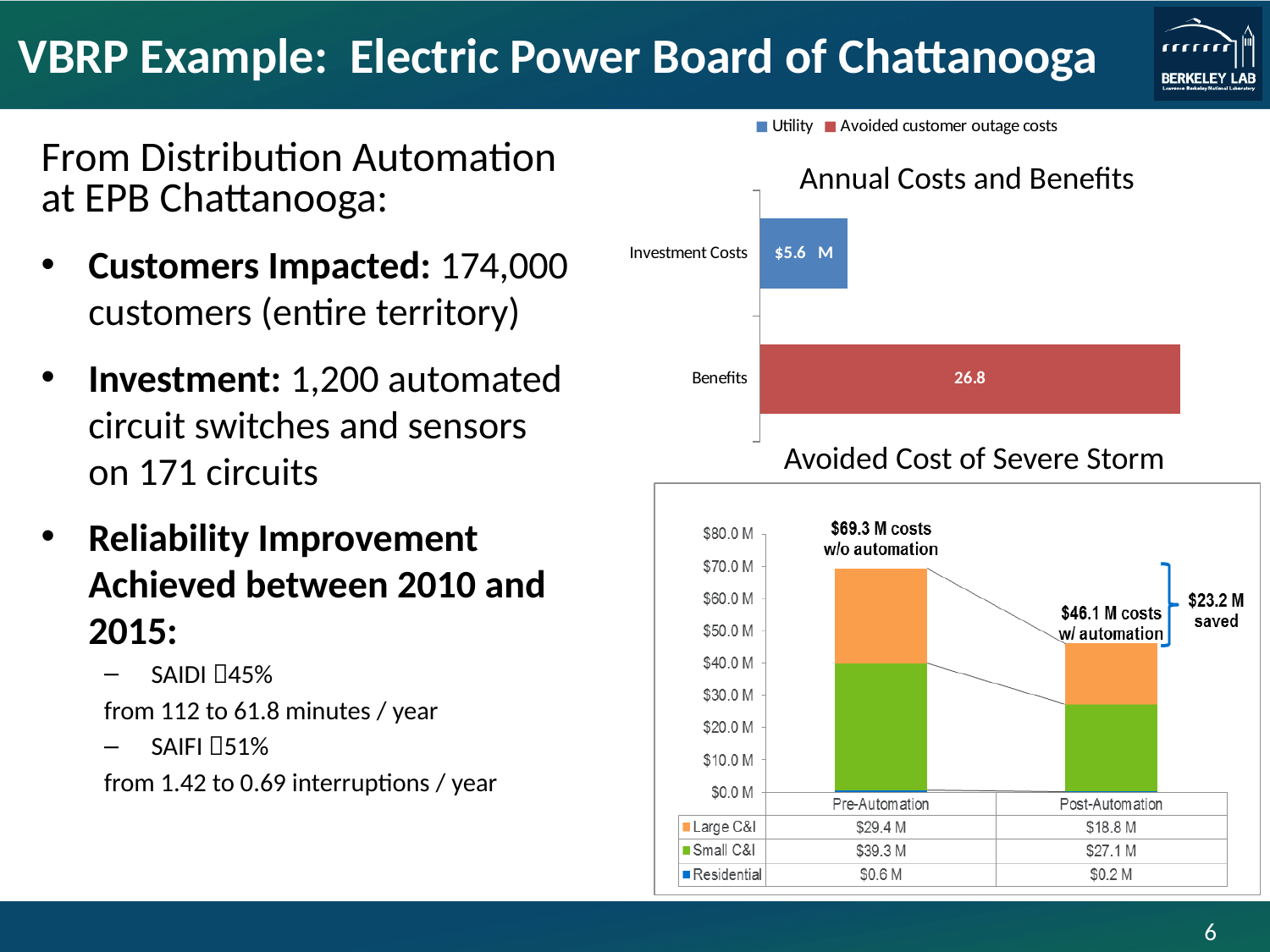
In the Avoided Cost of Severe Storm chart, what is the total cost of the Pre-Automation stacked bar? $69.3 M In the Avoided Cost of Severe Storm chart, what is the Small C&I value for Post-Automation? $27.1 M In the Avoided Cost of Severe Storm chart, what is the Residential value for Pre-Automation? $0.6 M In the Avoided Cost of Severe Storm chart, which series has the lowest value for Post-Automation? Residential In the Avoided Cost of Severe Storm chart, how many series does the legend list? 3 In the Annual Costs and Benefits chart, which category has the larger value, Investment Costs or Benefits? Benefits How many series does the legend of the Annual Costs and Benefits chart list? 2 In the Avoided Cost of Severe Storm chart, what is the Large C&I value for Pre-Automation? $29.4 M In the Avoided Cost of Severe Storm chart, what is the difference between the Small C&I values for Pre-Automation and Post-Automation? $12.2 M What kind of chart is the Annual Costs and Benefits chart? Bar chart In the Annual Costs and Benefits chart, what is the value for Investment Costs? $5.6 M In the Annual Costs and Benefits chart, what is the value for Benefits? 26.8